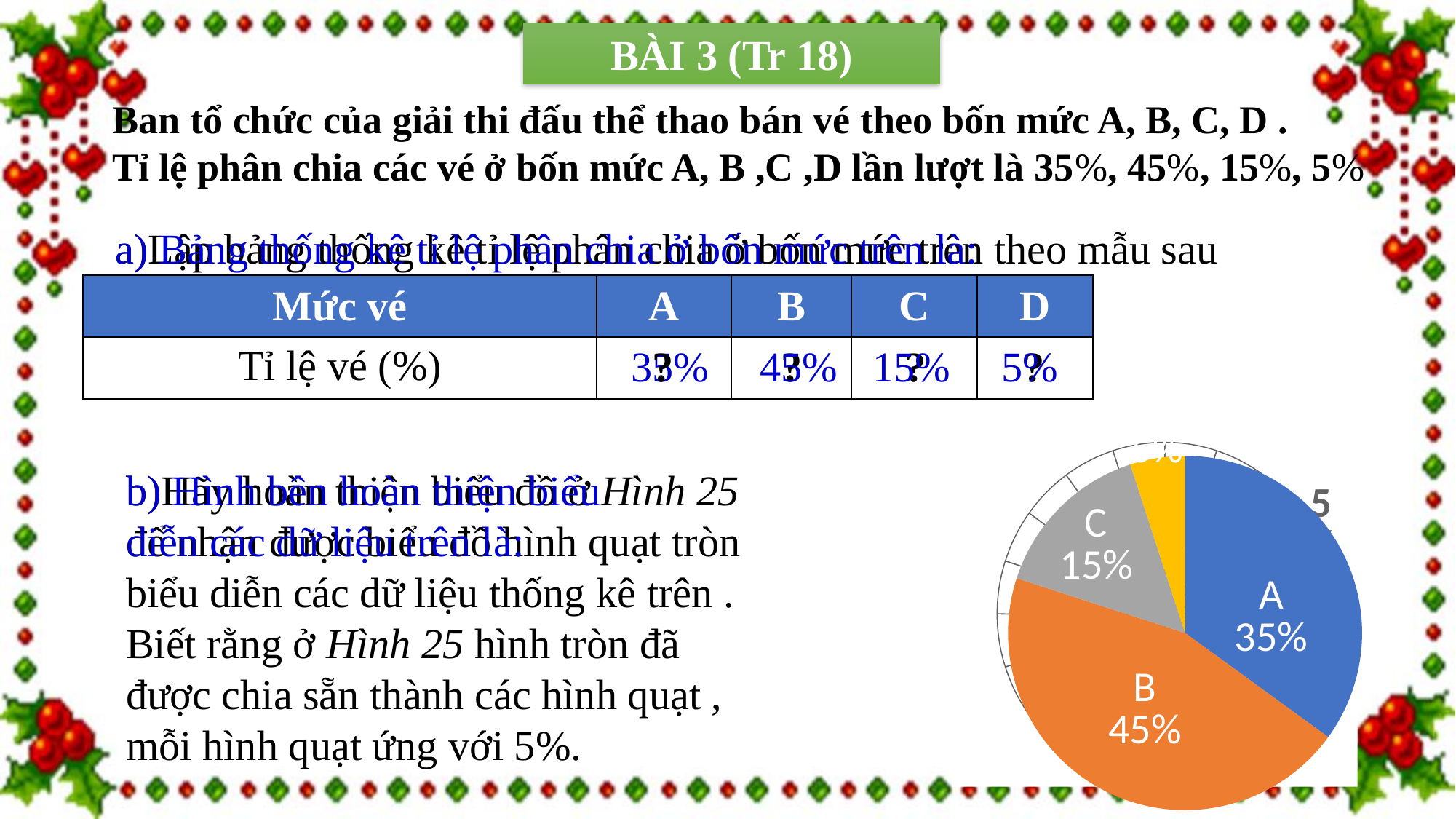
How many slices does the pie chart have? 4 What colour is slice B in the pie chart? orange What is the difference between the percentages of slices B and A in the pie chart? 10% What is the combined percentage of slices A and B in the pie chart? 80% Which is larger in the pie chart, slice A or slice C? A In the pie chart, what percentage is shown for slice A? 35% In the pie chart, what percentage is shown for slice B? 45% What kind of chart is shown on the slide? pie chart In the pie chart, what percentage is shown for slice C? 15% Which labelled slice of the pie chart is the largest? B Which slice of the pie chart is the smallest? the yellow slice (D) What colour is slice A in the pie chart? blue